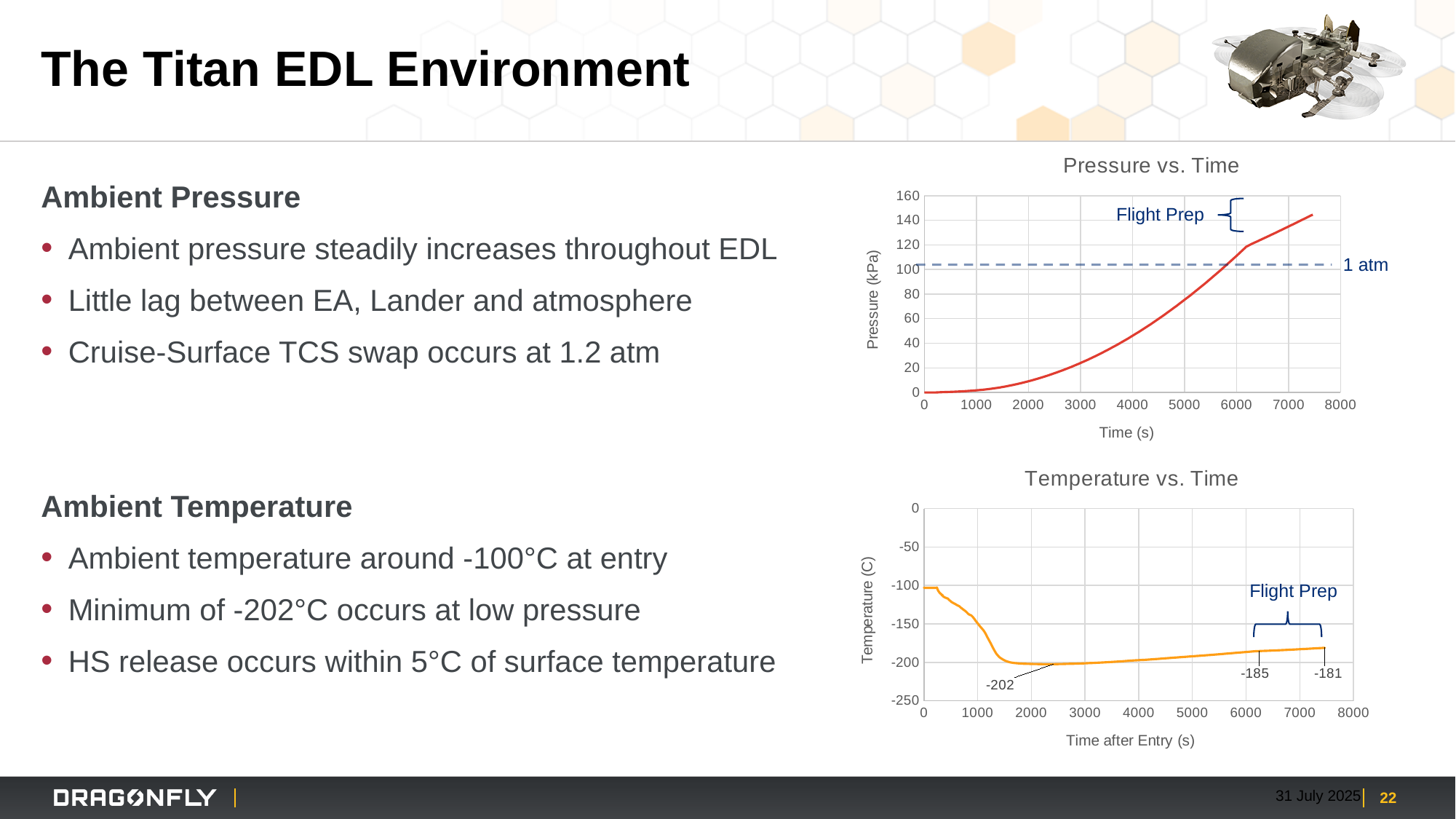
In the "Pressure vs. Time" chart, does the pressure rise or fall as time increases? rise In the "Pressure vs. Time" chart, is the pressure at 2000 s greater or less than 20? less What kind of chart is the "Pressure vs. Time" chart? line chart In the "Temperature vs. Time" chart, what is the difference between the labelled values -181 and -185? 4 In the "Temperature vs. Time" chart, is the temperature at 4000 s greater or less than -150? less In the "Temperature vs. Time" chart, what is the minimum temperature labelled on the curve? -202 In the "Pressure vs. Time" chart, what does the horizontal dashed line represent? 1 atm In the "Temperature vs. Time" chart, what is the temperature labelled at the start of the Flight Prep period, around 6200 s? -185 In the "Temperature vs. Time" chart, what is the temperature labelled at the end of the curve, around 7500 s? -181 What kind of chart is the "Temperature vs. Time" chart? line chart In the "Temperature vs. Time" chart, what is the label of the x axis? Time after Entry (s) In the "Pressure vs. Time" chart, is the pressure at 6000 s greater or less than 100? greater